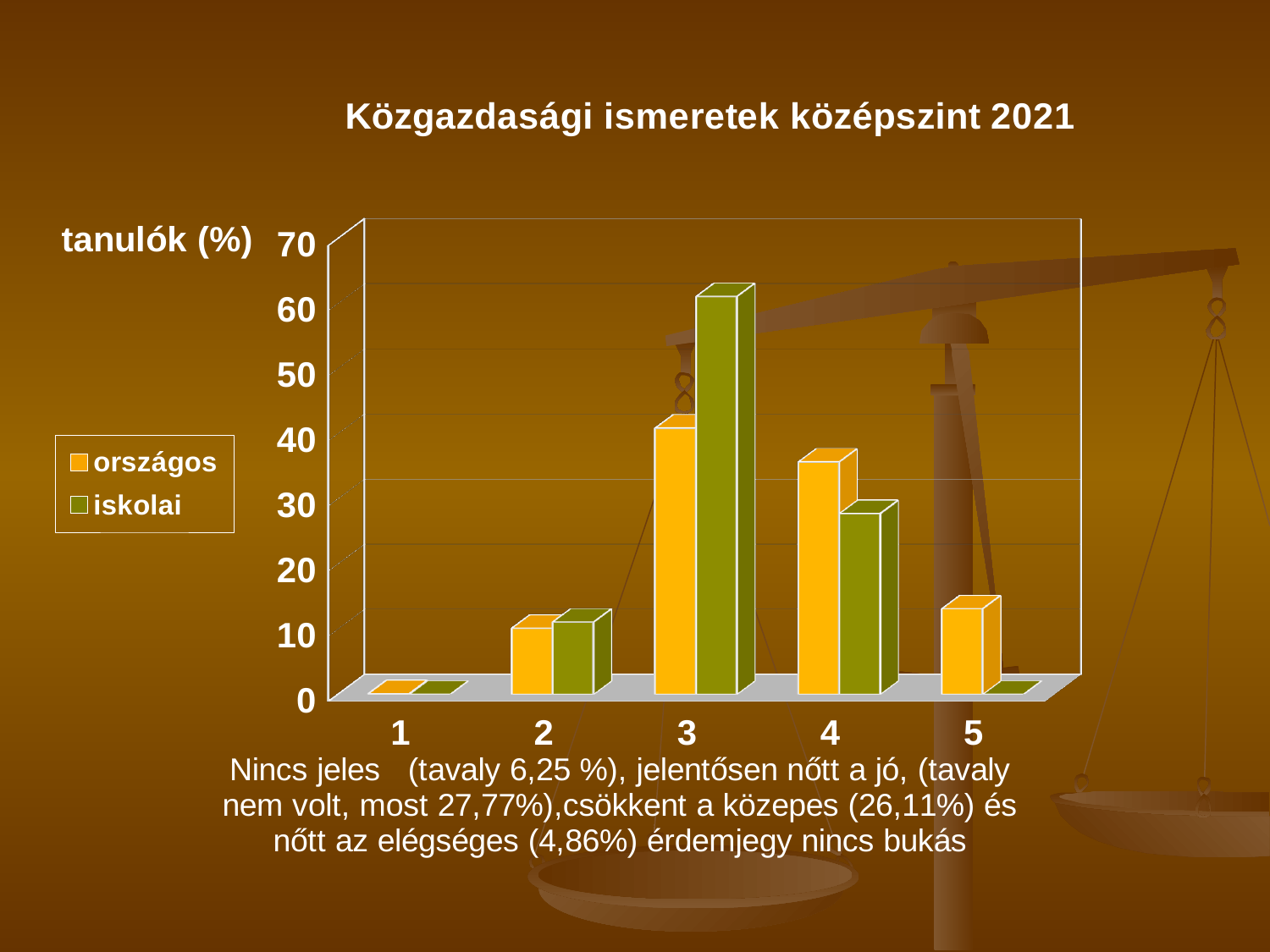
Which category has the highest value for the országos series? 3 Is the országos value for category 4 greater or less than 30? greater Is the országos value for category 5 greater or less than 20? less For category 4, which series has the larger value, országos or iskolai? országos For category 3, which series has the larger value, országos or iskolai? iskolai Is the iskolai value for category 3 greater or less than 50? greater What is the title of the chart? Közgazdasági ismeretek középszint 2021 How many categories are shown on the x axis? 5 Which category has the highest value for the iskolai series? 3 What kind of chart is shown on the slide? bar chart How many series does the legend list? 2